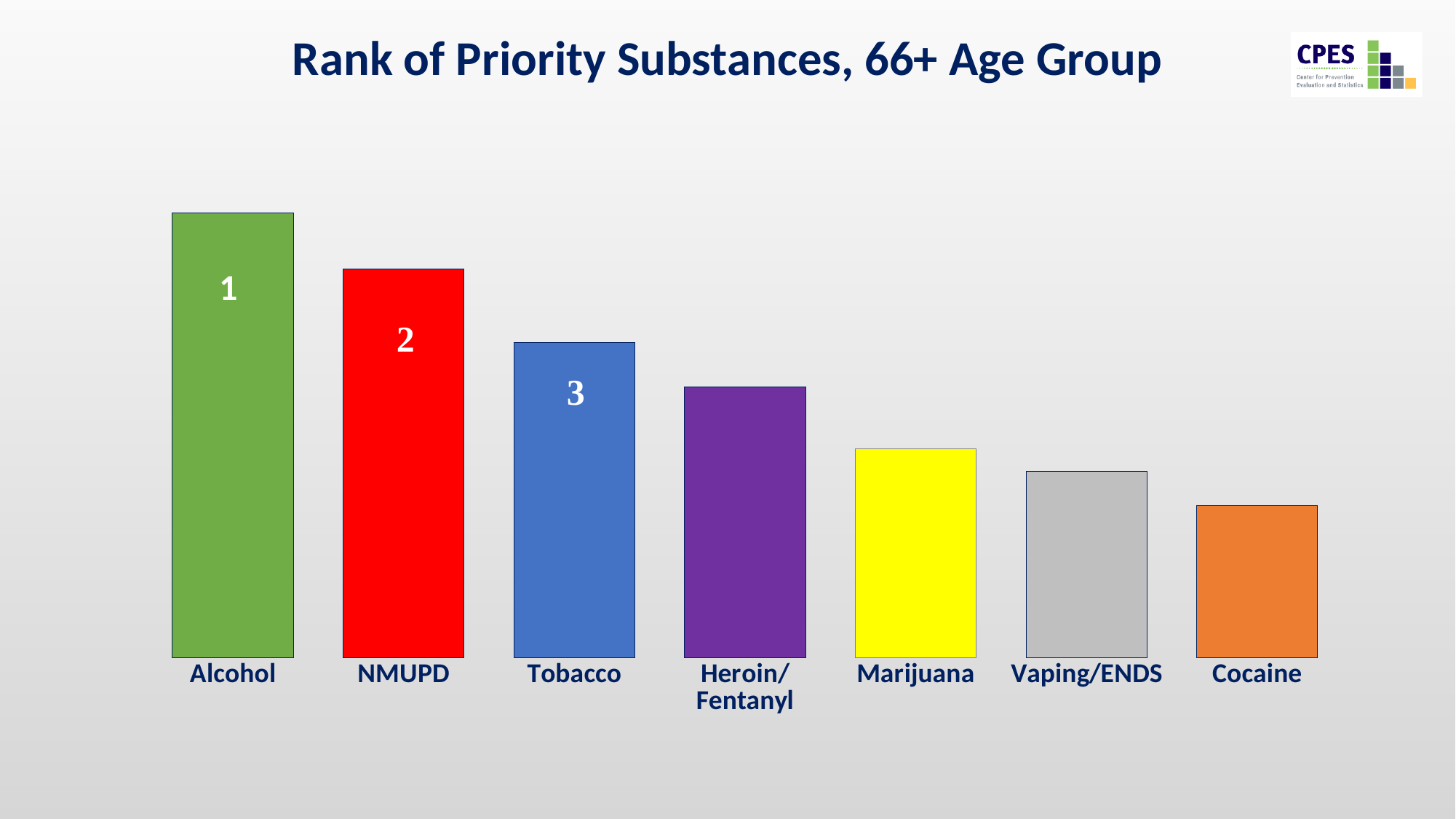
Which bar is taller, Vaping/ENDS or Heroin/Fentanyl? Heroin/Fentanyl What rank label is shown on the NMUPD bar? 2 Which bar is taller, Tobacco or Marijuana? Tobacco What is the title of the chart? Rank of Priority Substances, 66+ Age Group What rank label is shown on the Tobacco bar? 3 Which substance is labelled with rank 2? NMUPD Which substance has the shortest bar? Cocaine What kind of chart is shown on the slide? Bar chart Which substance has the tallest bar? Alcohol Do the bar heights rise or fall from left to right across the chart? Fall What rank label is shown on the Alcohol bar? 1 How many substances are shown in the chart? 7